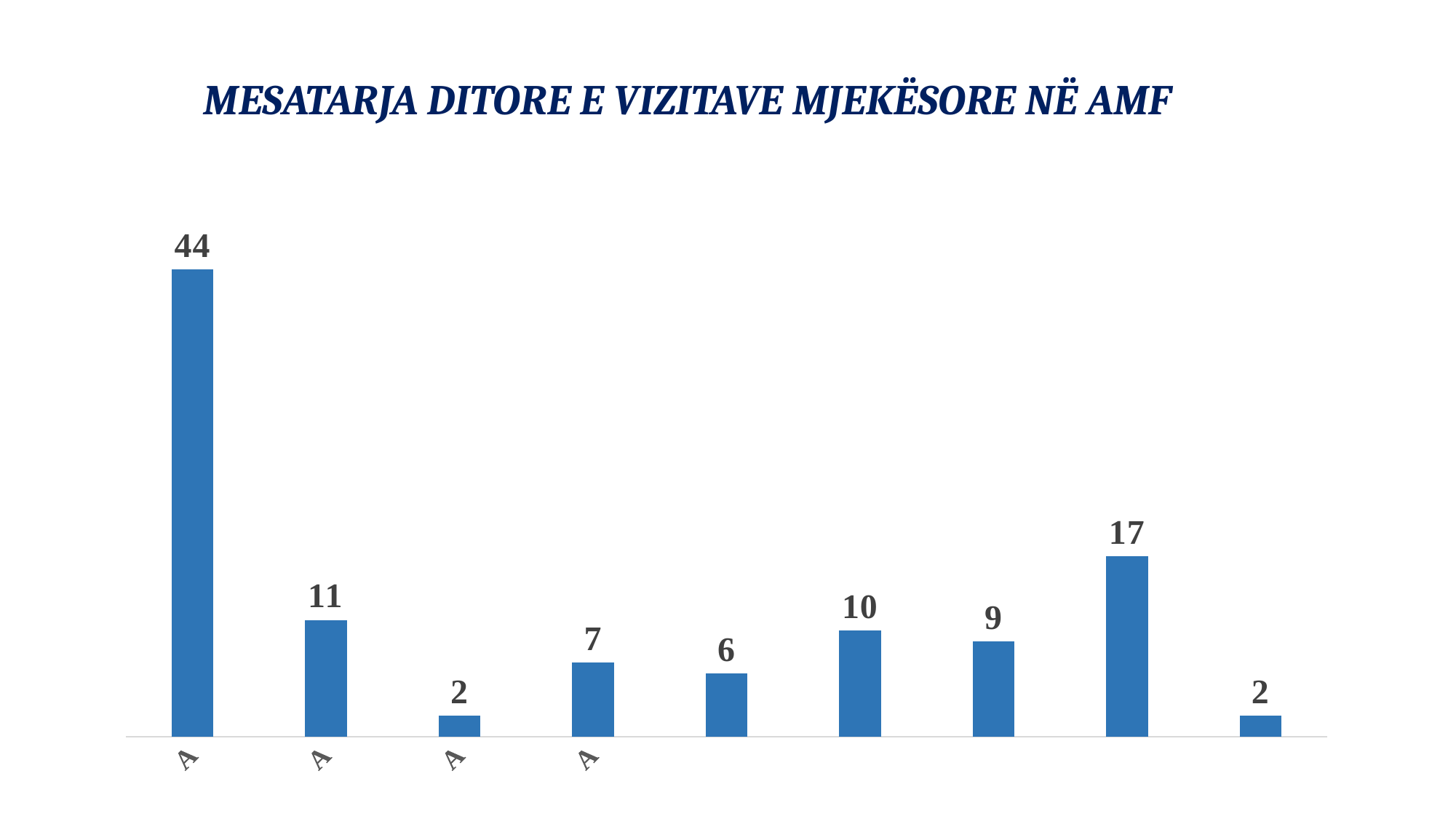
Which is larger, the fourth bar from the left or the fifth bar from the left? the fourth bar (7) What is the difference between the second bar (11) and the seventh bar (9)? 2 What is the title of the chart? MESATARJA DITORE E VIZITAVE MJEKËSORE NË AMF What is the difference between the first bar (44) and the eighth bar (17)? 27 What is the value of the sixth bar from the left? 10 What is the value of the first (leftmost) bar? 44 What is the value of the second bar from the left? 11 What is the value of the eighth bar from the left? 17 What kind of chart is shown on the slide? bar chart How many bars does the chart show? 9 What is the highest value shown in the chart? 44 What is the lowest value shown in the chart? 2